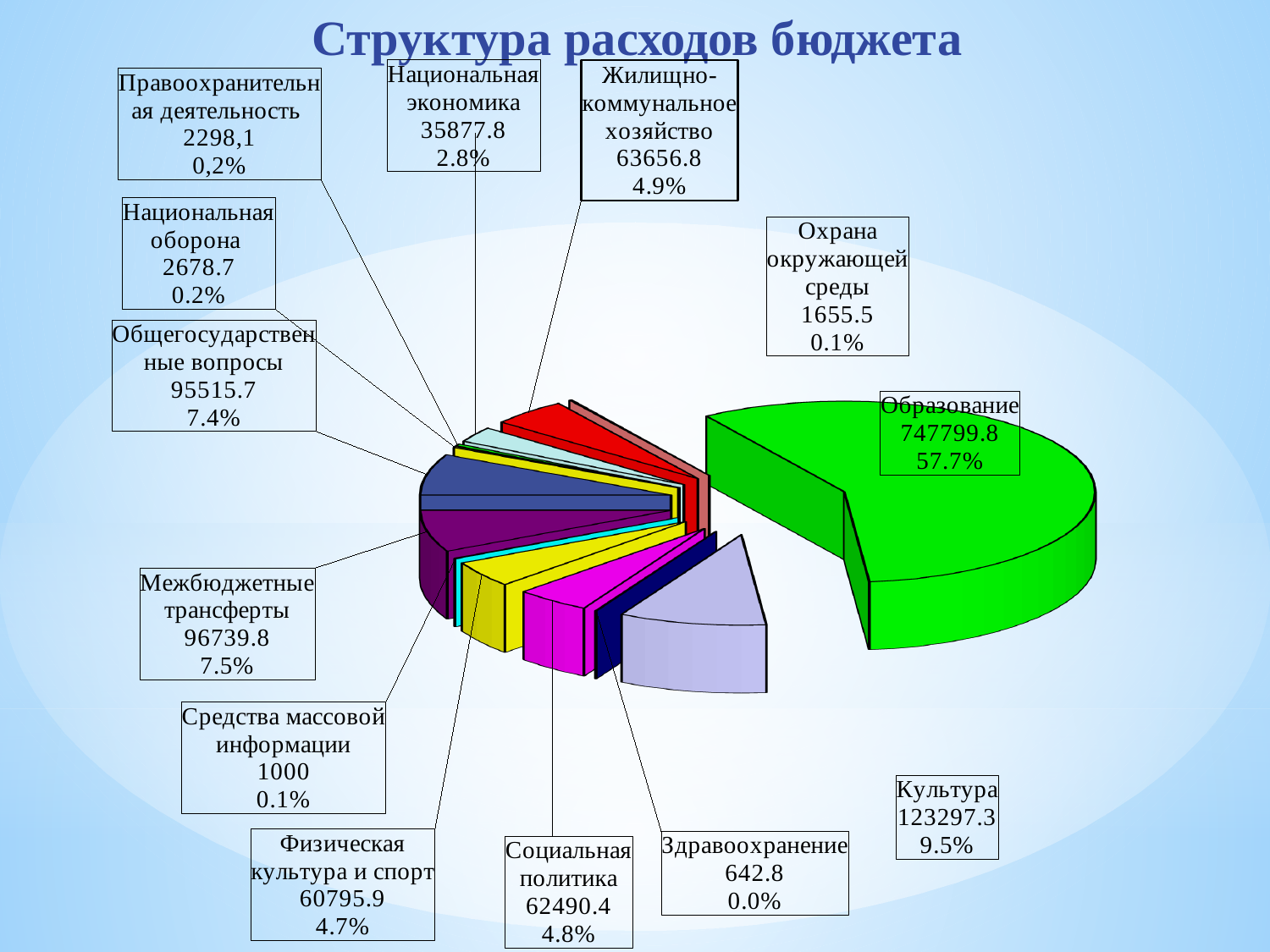
What kind of chart is shown on the slide? Pie chart Which category has the smallest value? Здравоохранение Which is larger, the value for Межбюджетные трансферты or the value for Общегосударственные вопросы? Межбюджетные трансферты Which category has the largest share of the pie? Образование How many categories (slices) does the pie chart have? 13 What is the difference between the values for Образование and Культура? 624502.5 What share of the pie does Образование represent? 57.7% What is the value shown for Культура? 123297.3 What is the title of the chart? Структура расходов бюджета What is the value shown for Образование? 747799.8 What share of the pie does Культура represent? 9.5% What is the value shown for Жилищно-коммунальное хозяйство? 63656.8